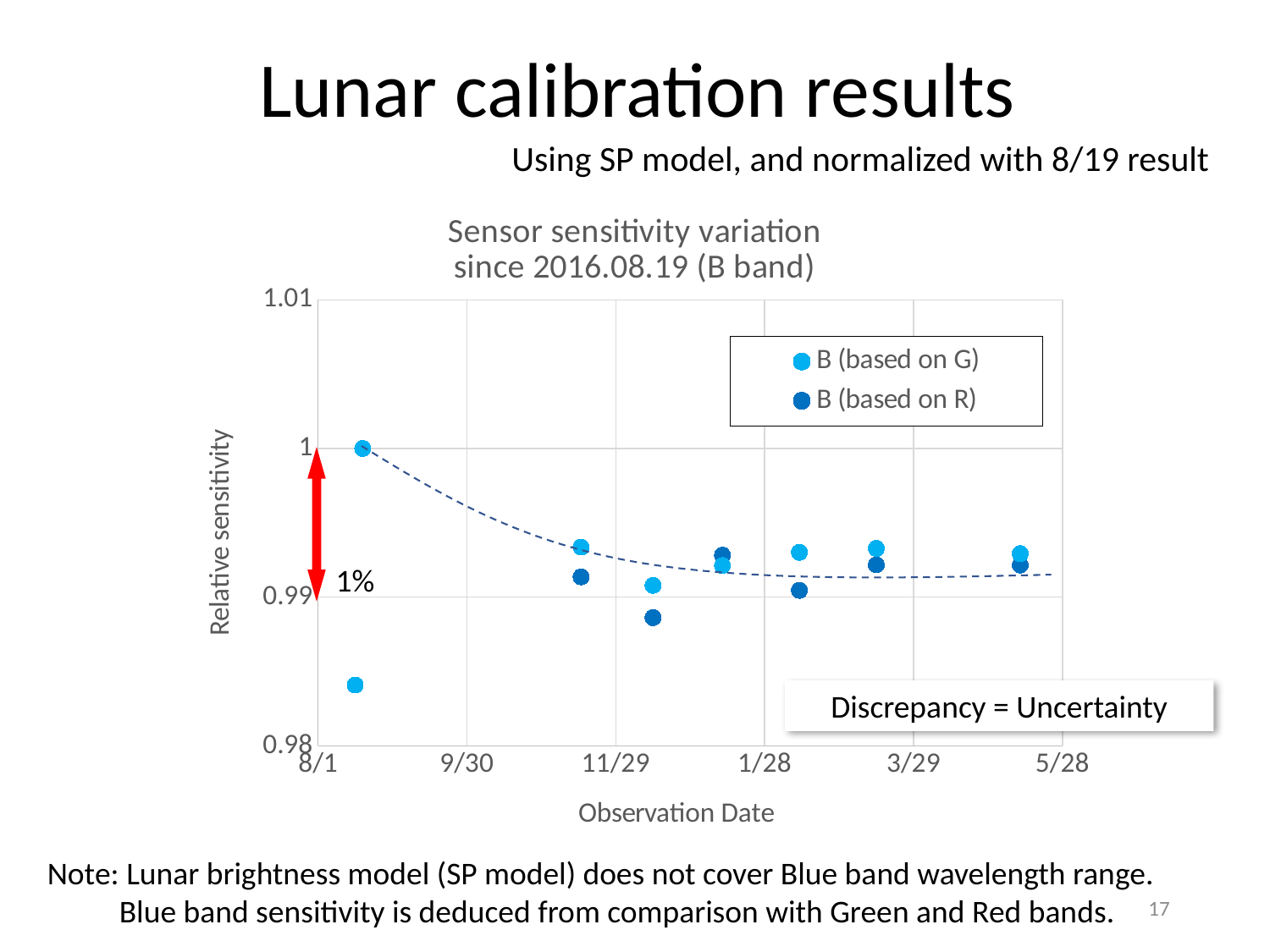
Is the B (based on G) value near 5/28 greater or less than 0.99? greater Is the lowest plotted point, near 8/1, greater or less than 0.99? less Which series contains the lowest plotted point on the chart? B (based on G) Is the highest plotted point, near 8/1, greater or less than 0.99? greater Does the dashed trend line rise or fall between 8/1 and 11/29? fall What kind of chart is shown on the slide? Scatter chart What are the two series named in the legend? B (based on G) and B (based on R) What is the title of the chart? Sensor sensitivity variation since 2016.08.19 (B band) How many series does the legend list? 2 How many date labels are shown on the x axis? 6 Near 11/29, which is larger: the B (based on G) value or the B (based on R) value? B (based on G)